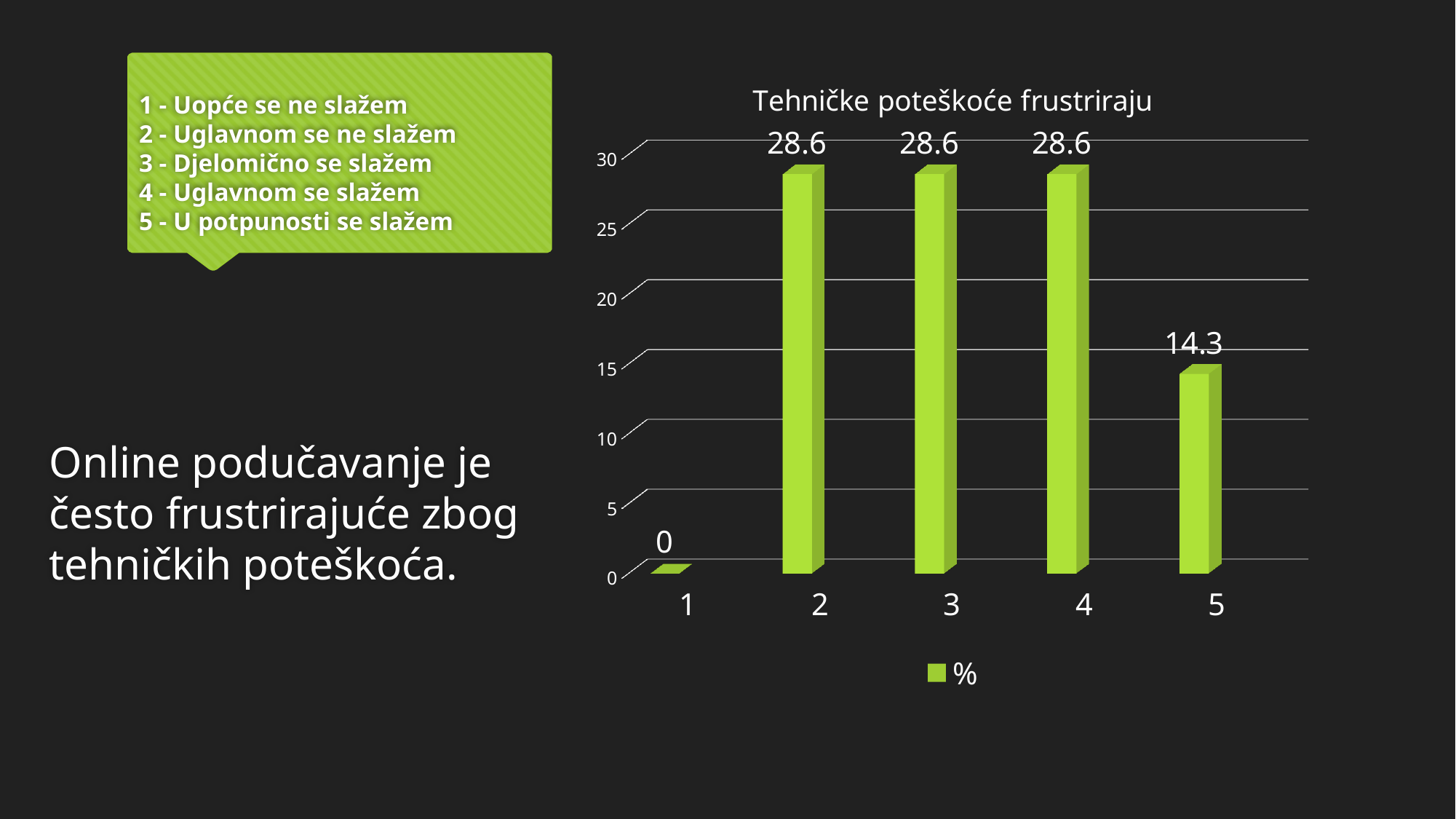
Which is larger, the value for category 3 or the value for category 5? category 3 What is the value for category 1? 0 How many series does the legend list? 1 What is the difference between the values for category 4 and category 5? 14.3 Is the value for category 5 greater or less than 10? greater Which category has the lowest value? 1 What is the title of the chart? Tehničke poteškoće frustriraju What kind of chart is shown? bar chart What is the value for category 5? 14.3 What is the legend entry for the series? % How many categories are shown on the x axis? 5 What is the value for category 2? 28.6